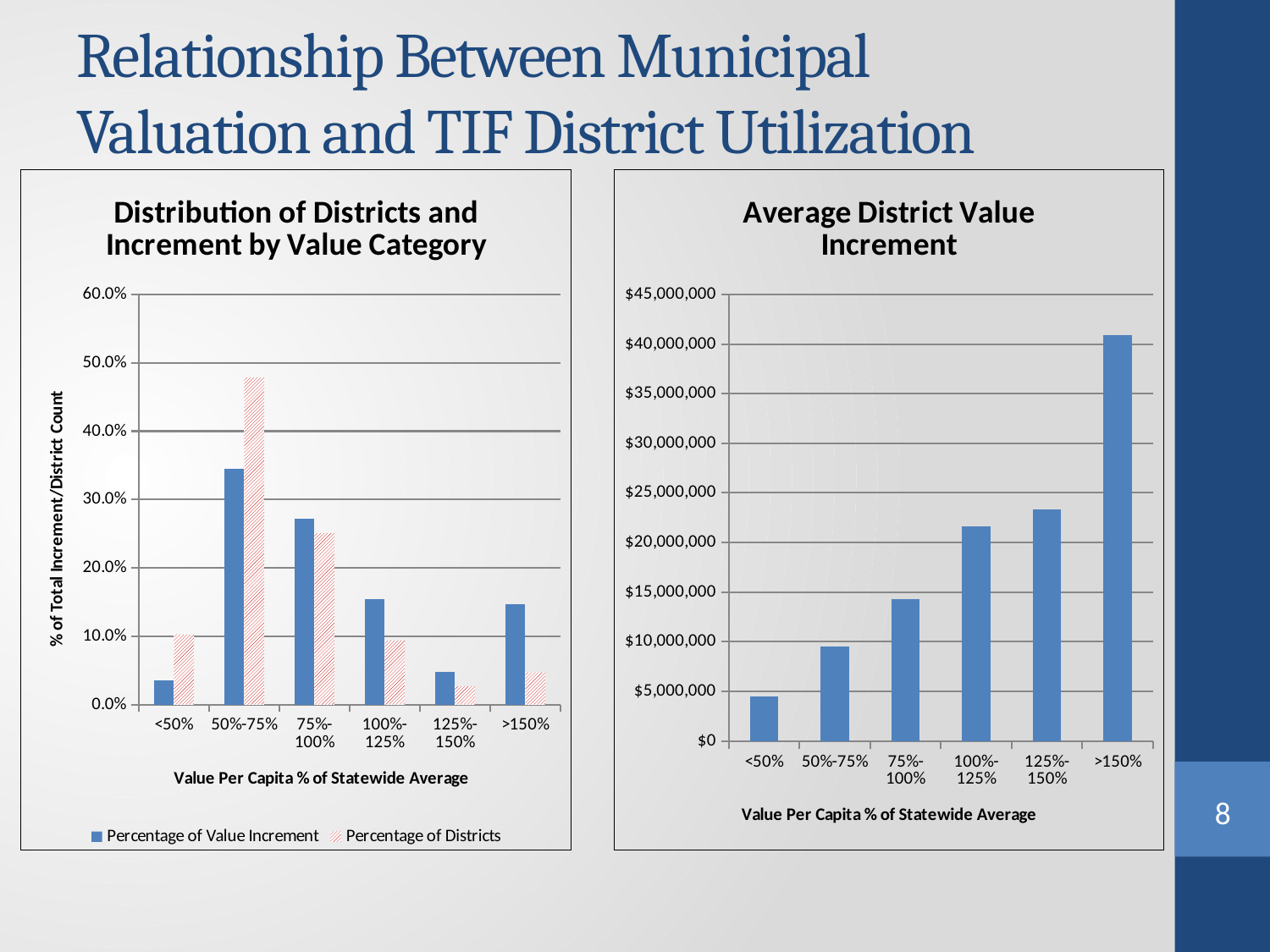
In the 'Average District Value Increment' chart, do the values rise or fall moving from <50% to >150% along the x axis? rise How many value categories are shown on the x axis of the 'Average District Value Increment' chart? 6 What kind of chart is the 'Distribution of Districts and Increment by Value Category' chart? bar chart In the 'Average District Value Increment' chart, is the value for >150% greater or less than $35,000,000? greater In the 'Distribution of Districts and Increment by Value Category' chart, is the Percentage of Districts for 50%-75% greater or less than 40.0%? greater In the 'Distribution of Districts and Increment by Value Category' chart, which value category has the highest Percentage of Value Increment? 50%-75% In the 'Average District Value Increment' chart, which value category has the lowest average district value increment? <50% In the 'Distribution of Districts and Increment by Value Category' chart, for the >150% category, which is larger: Percentage of Value Increment or Percentage of Districts? Percentage of Value Increment In the 'Average District Value Increment' chart, is the value for 125%-150% greater or less than $20,000,000? greater How many series does the legend of the 'Distribution of Districts and Increment by Value Category' chart list? 2 In the 'Average District Value Increment' chart, which value category has the highest average district value increment? >150% In the 'Distribution of Districts and Increment by Value Category' chart, which value category has the highest Percentage of Districts? 50%-75%